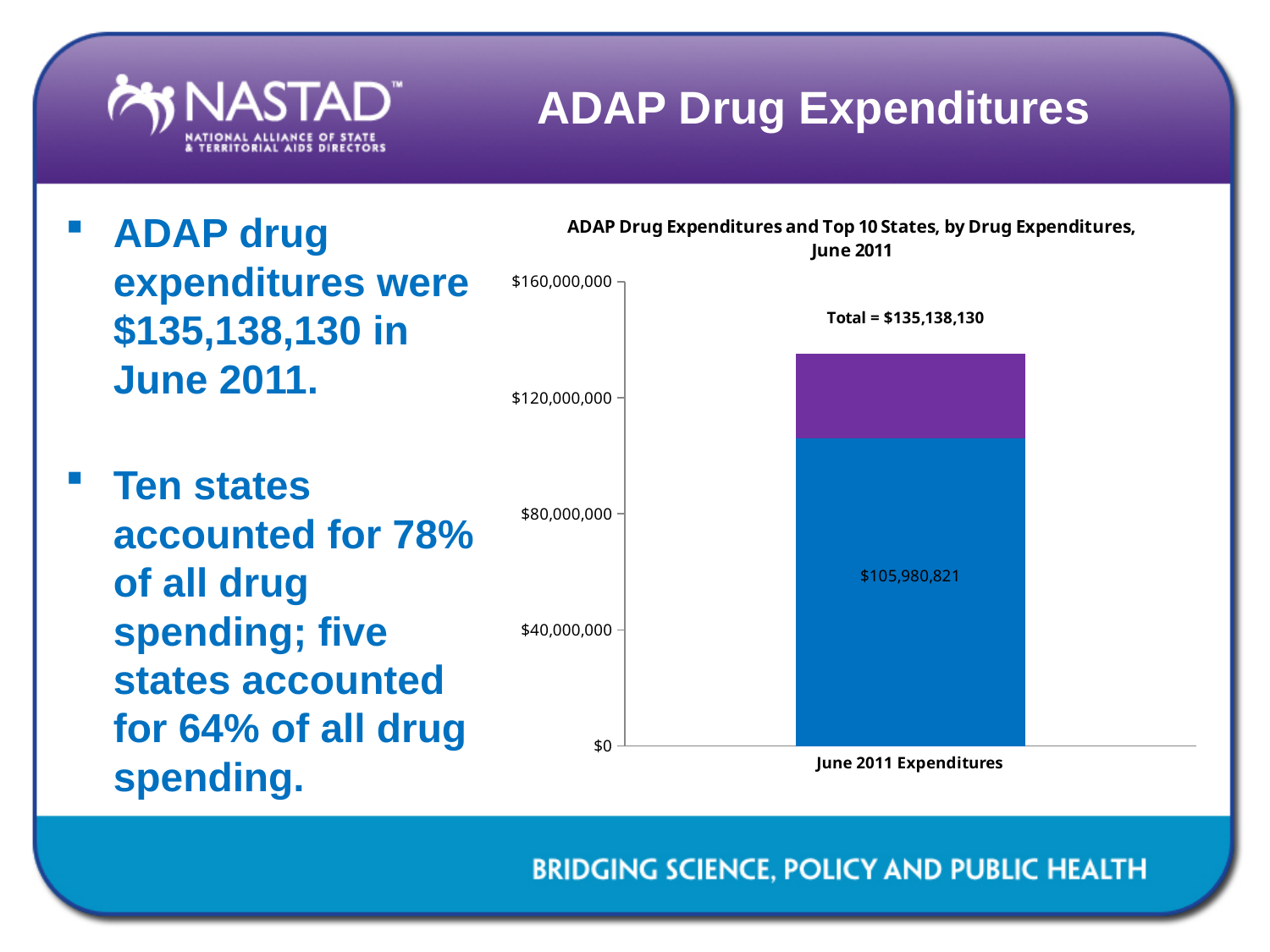
What is the title of the chart? ADAP Drug Expenditures and Top 10 States, by Drug Expenditures, June 2011 What kind of chart is shown on the slide? Stacked bar chart How many categories are plotted on the x axis? 1 What is the total of the stacked bar for June 2011 Expenditures? $135,138,130 Is the total of the stacked bar greater or less than $120,000,000? greater Is the total of the stacked bar greater or less than $160,000,000? less Which segment of the bar is larger, the blue segment or the purple segment? The blue segment What is the label of the category on the x axis? June 2011 Expenditures Is the value of the blue segment greater or less than $80,000,000? greater What is the difference between the total of the bar and the blue segment's value? $29,157,309 What is the highest value shown on the y axis? $160,000,000 What is the value printed on the blue (bottom) segment of the bar? $105,980,821